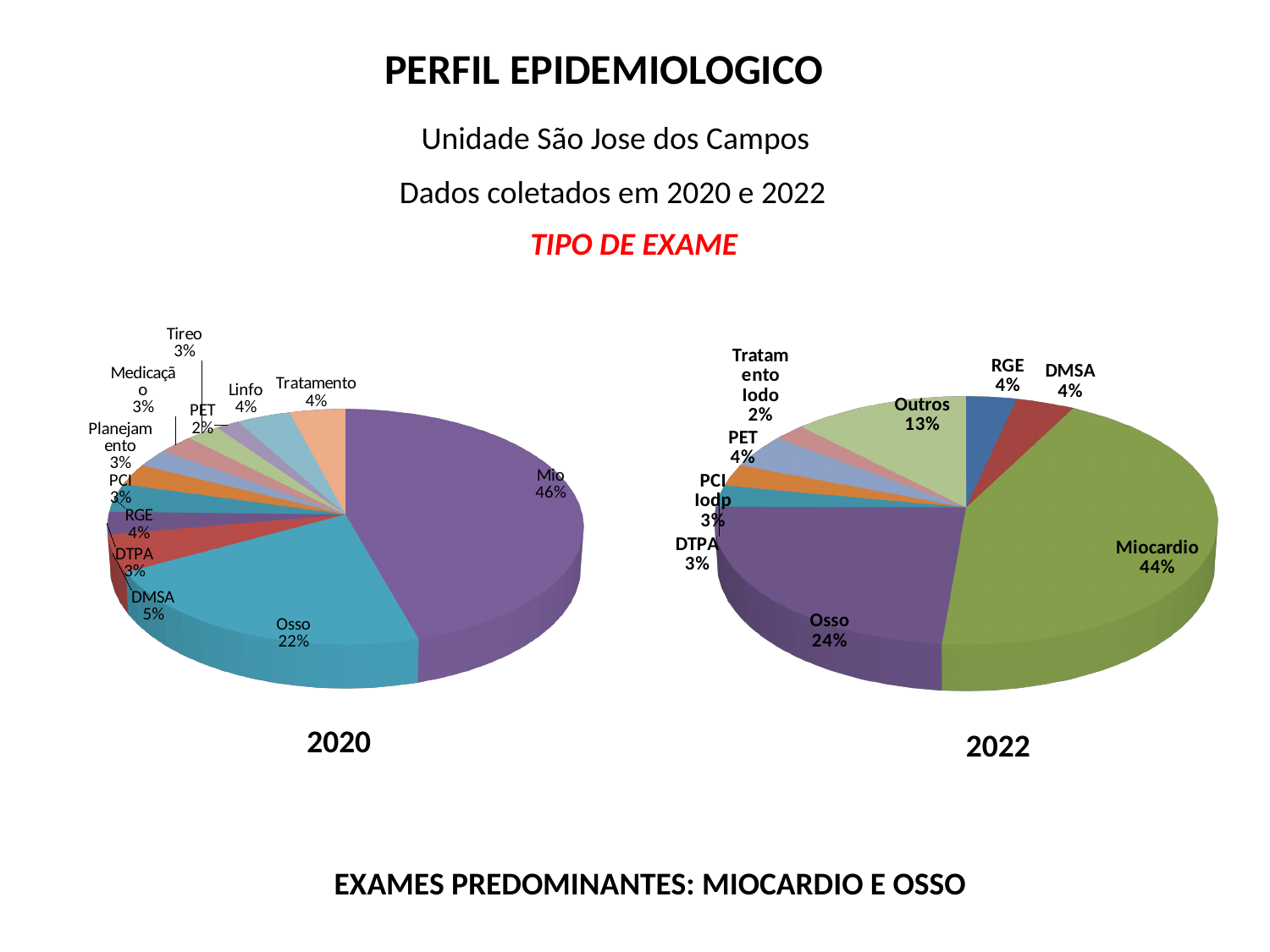
In the 2022 pie chart, which category has the smallest slice? Tratamento Iodo In the 2020 pie chart, what is the difference between the Mio and Osso shares? 24% In the 2022 pie chart, which category has the largest slice? Miocardio In the 2022 pie chart, which is larger, Osso or Outros? Osso In the 2020 pie chart, what share does Mio have? 46% In the 2022 pie chart, what share does Outros have? 13% How many slices does the 2020 pie chart have? 12 In the 2020 pie chart, which category has the largest slice? Mio In the 2020 pie chart, which category has the smallest slice? PET How many slices does the 2022 pie chart have? 9 In the 2022 pie chart, what share does Osso have? 24% What type of chart is used for the 2022 data? Pie chart